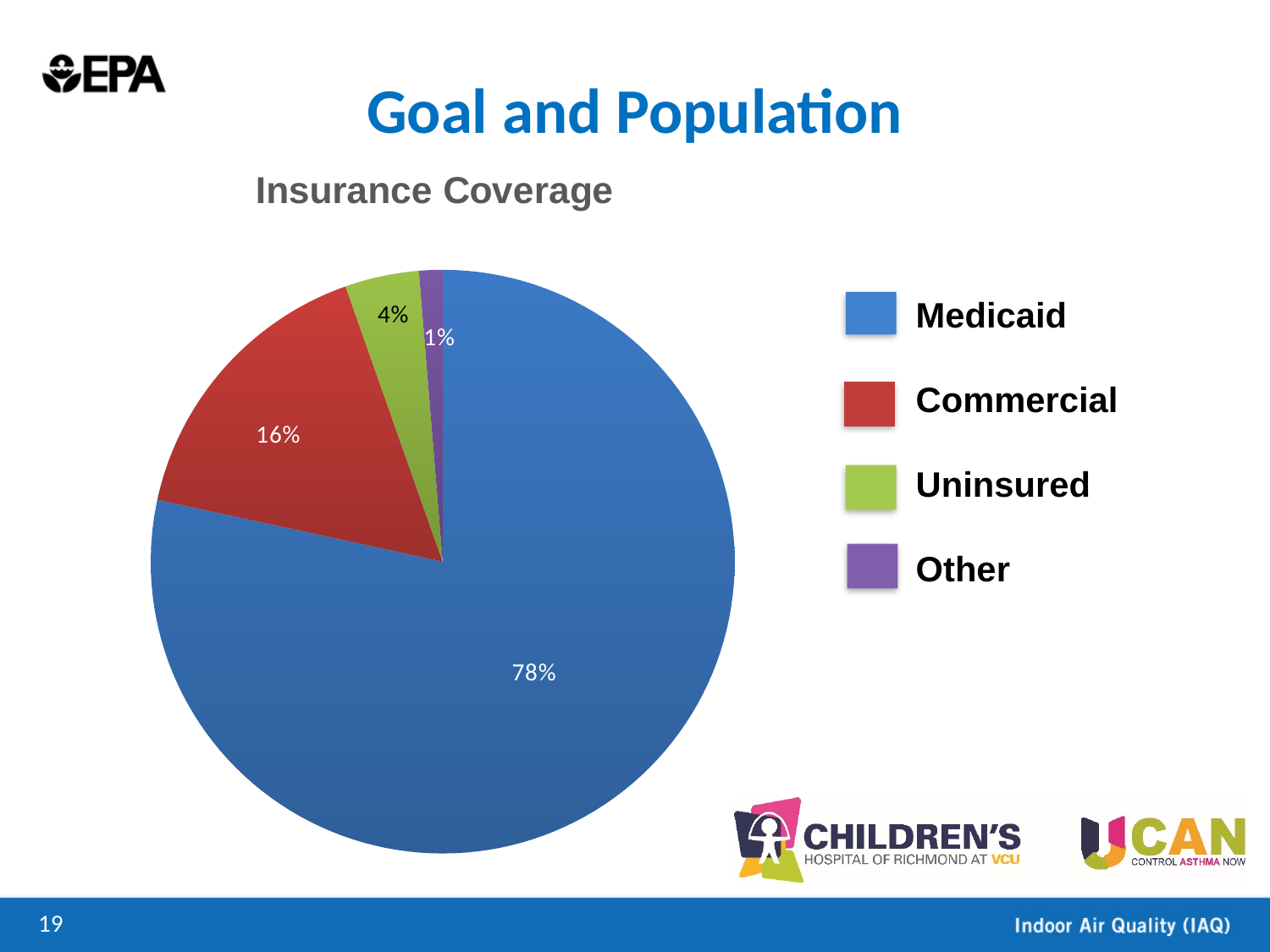
Which is larger, the Commercial share or the Uninsured share? Commercial How many categories does the pie chart show? 4 Which insurance category has the largest share? Medicaid What share of the pie is Other? 1% What share of the pie is Commercial? 16% What type of chart is shown on the slide? pie chart What share of the pie is Medicaid? 78% What is the title of the chart? Insurance Coverage Which insurance category has the smallest share? Other What is the difference in percentage points between Medicaid and Commercial? 62 What colour is the Uninsured slice? green